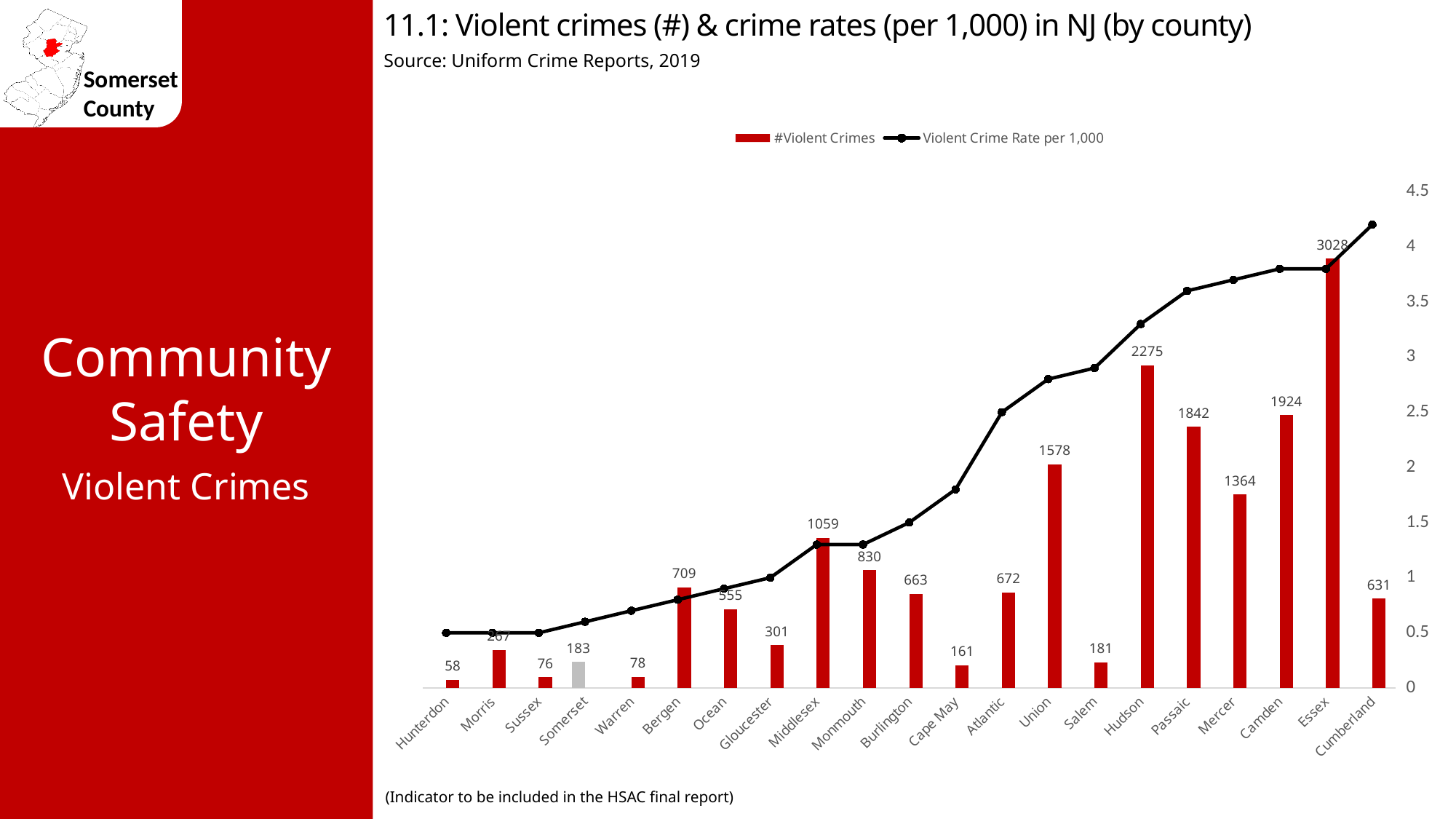
Which county has the highest number of violent crimes? Essex What kind of chart is this? Combination bar and line chart What is the difference in the number of violent crimes between Hudson and Passaic? 433 Which county has the lowest number of violent crimes? Hunterdon How many counties are shown on the x axis? 21 What is the number of violent crimes for Essex? 3028 How many series does the legend list? 2 Which county has more violent crimes, Camden or Passaic? Camden Is the violent crime rate per 1,000 for Cumberland greater or less than 4? greater What is the number of violent crimes for Somerset? 183 Which county's bar is coloured grey instead of red? Somerset Does the violent crime rate per 1,000 line generally rise or fall from Hunterdon to Cumberland? Rise